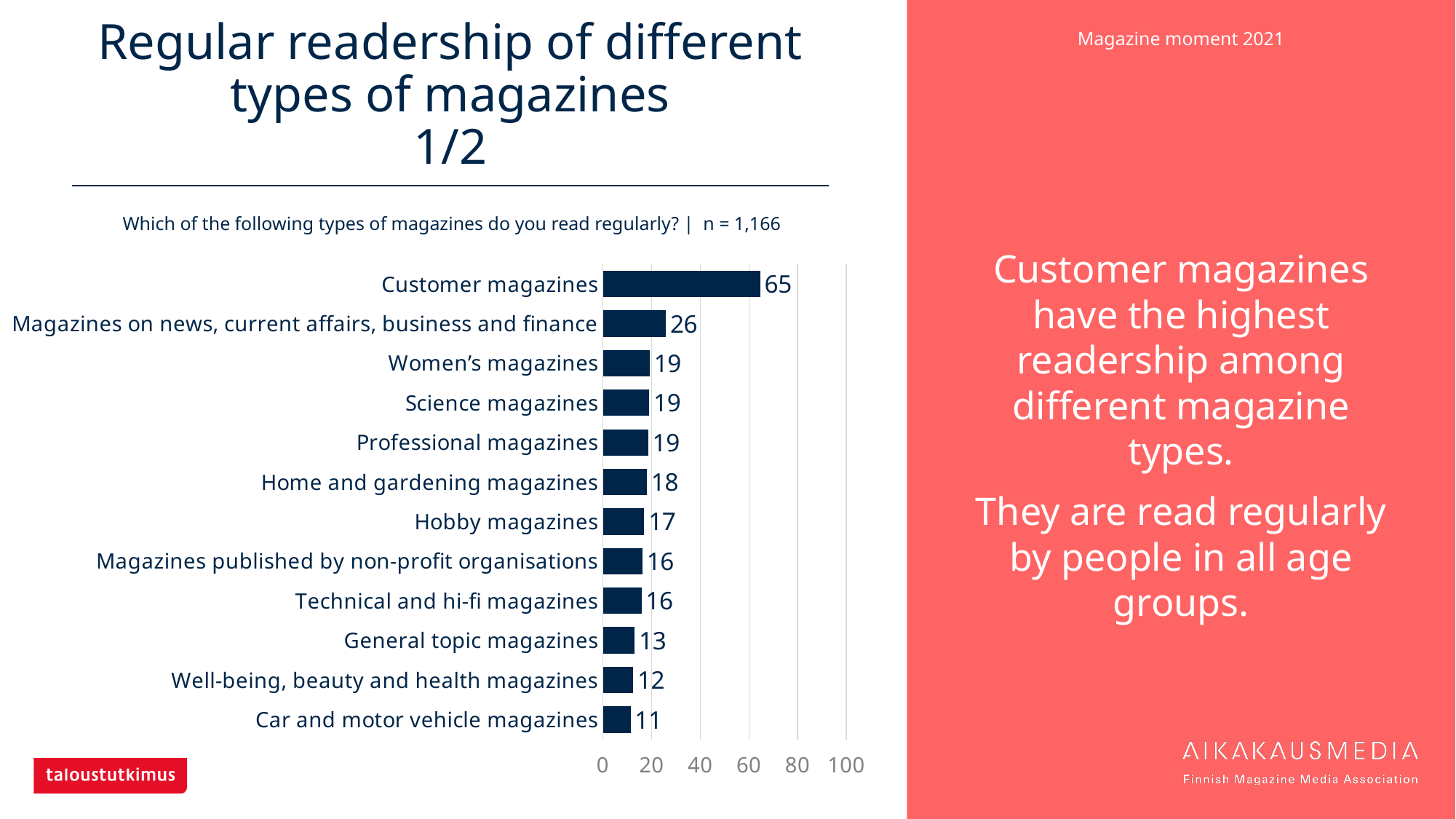
What is the value for Customer magazines? 65 What is the value for Hobby magazines? 17 Which type of magazine has the lowest value? Car and motor vehicle magazines Is the value for Customer magazines greater or less than 60? greater What is the value for Car and motor vehicle magazines? 11 How many types of magazines are shown in the chart? 12 What is the value for Magazines on news, current affairs, business and finance? 26 Which type of magazine has the highest value? Customer magazines Which is larger, the value for Home and gardening magazines or the value for General topic magazines? Home and gardening magazines What is the sample size (n) stated above the chart? n = 1,166 What kind of chart is shown on the slide? bar chart What is the difference between the values for Customer magazines and Magazines on news, current affairs, business and finance? 39